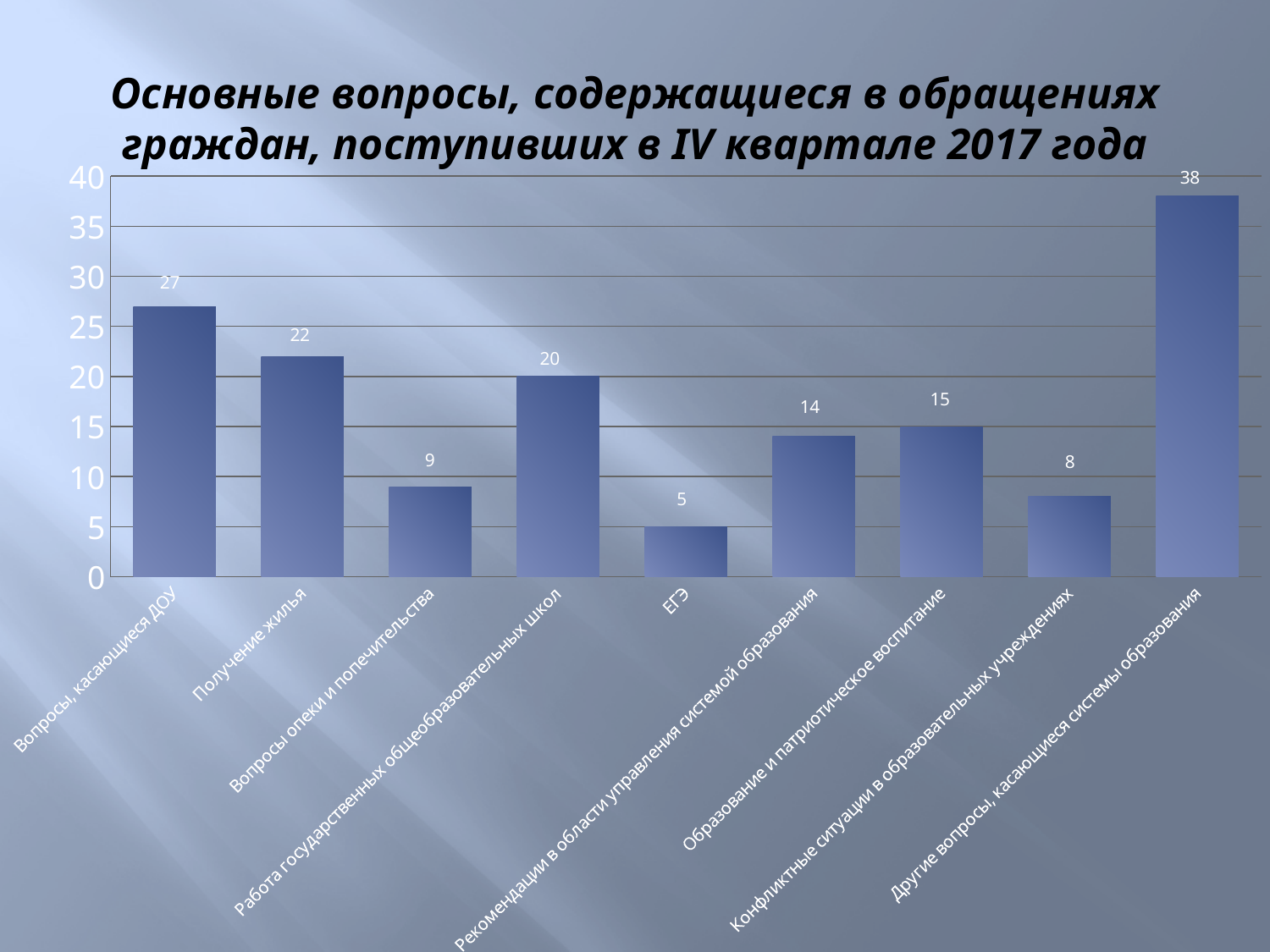
What is the difference between the values for "Другие вопросы, касающиеся системы образования" and "Вопросы, касающиеся ДОУ"? 11 What is the value for "Вопросы, касающиеся ДОУ"? 27 Which category has the lowest value? ЕГЭ How many categories are shown on the chart? 9 Which category has the highest value? Другие вопросы, касающиеся системы образования What is the value for "ЕГЭ"? 5 Which is larger: the value for "Получение жилья" or the value for "Работа государственных общеобразовательных школ"? Получение жилья What is the title of the chart? Основные вопросы, содержащиеся в обращениях граждан, поступивших в IV квартале 2017 года What is the difference between the values for "Вопросы опеки и попечительства" and "ЕГЭ"? 4 What is the value for "Образование и патриотическое воспитание"? 15 What kind of chart is shown on the slide? bar chart Is the value for "Конфликтные ситуации в образовательных учреждениях" greater or less than 10? less